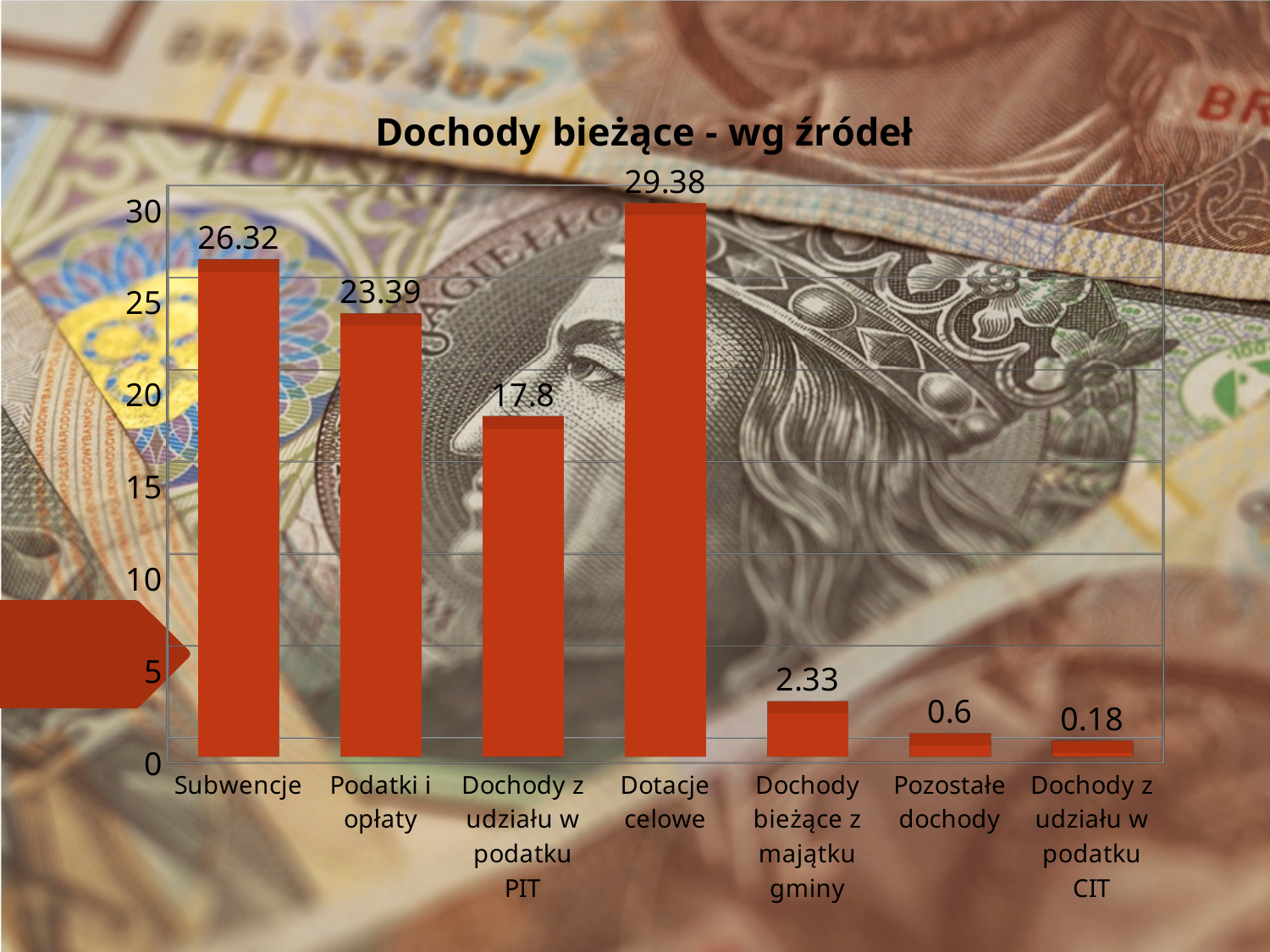
What is the value for Dotacje celowe? 29.38 What type of chart is shown on the slide? bar chart What is the value for Subwencje? 26.32 Which category has the lowest value? Dochody z udziału w podatku CIT How many categories are shown in the chart? 7 What is the difference between the values for Dotacje celowe and Subwencje? 3.06 Is the value for Dochody z udziału w podatku PIT greater or less than 20? less What is the value for Pozostałe dochody? 0.6 What is the difference between the values for Podatki i opłaty and Dochody z udziału w podatku PIT? 5.59 Which is larger, the value for Podatki i opłaty or the value for Dochody bieżące z majątku gminy? Podatki i opłaty Which category has the highest value? Dotacje celowe What is the value for Dochody z udziału w podatku CIT? 0.18